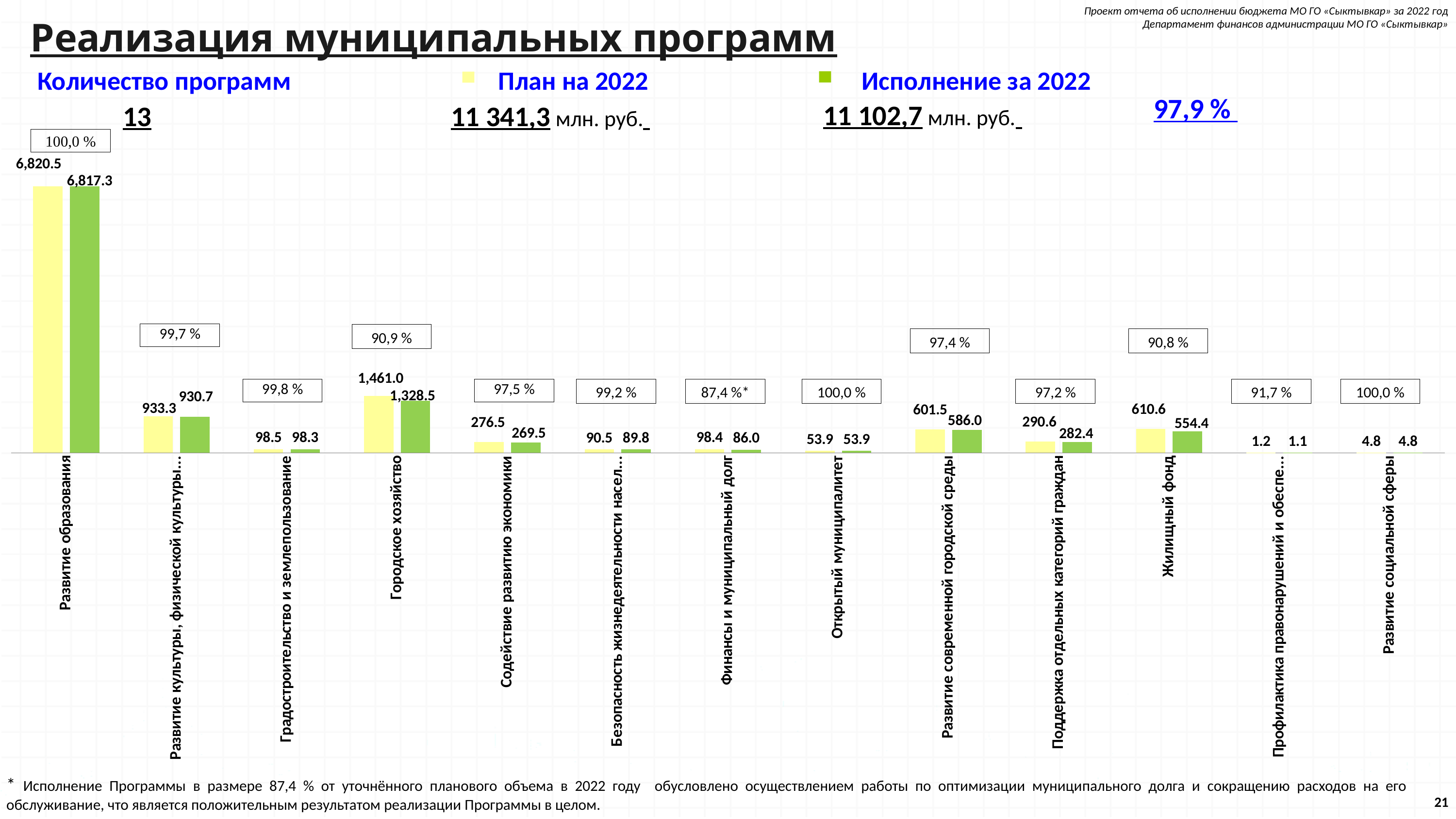
What is the Исполнение за 2022 value for Городское хозяйство? 1,328.5 What kind of chart is shown on the slide? bar chart What is the difference between the План на 2022 and Исполнение за 2022 values for Финансы и муниципальный долг? 12.4 Which is larger: the Исполнение за 2022 value for Развитие современной городской среды or for Жилищный фонд? Развитие современной городской среды What is the Исполнение за 2022 value for Жилищный фонд? 554.4 Which category has the highest План на 2022 value? Развитие образования Which category has the lowest Исполнение за 2022 value? Профилактика правонарушений и обеспе... How many categories are shown on the x axis of the chart? 13 What execution percentage is shown in the box above Городское хозяйство? 90,9 % What is the План на 2022 value for Открытый муниципалитет? 53.9 How many series does the legend list? 2 What is the План на 2022 value for Развитие образования? 6,820.5